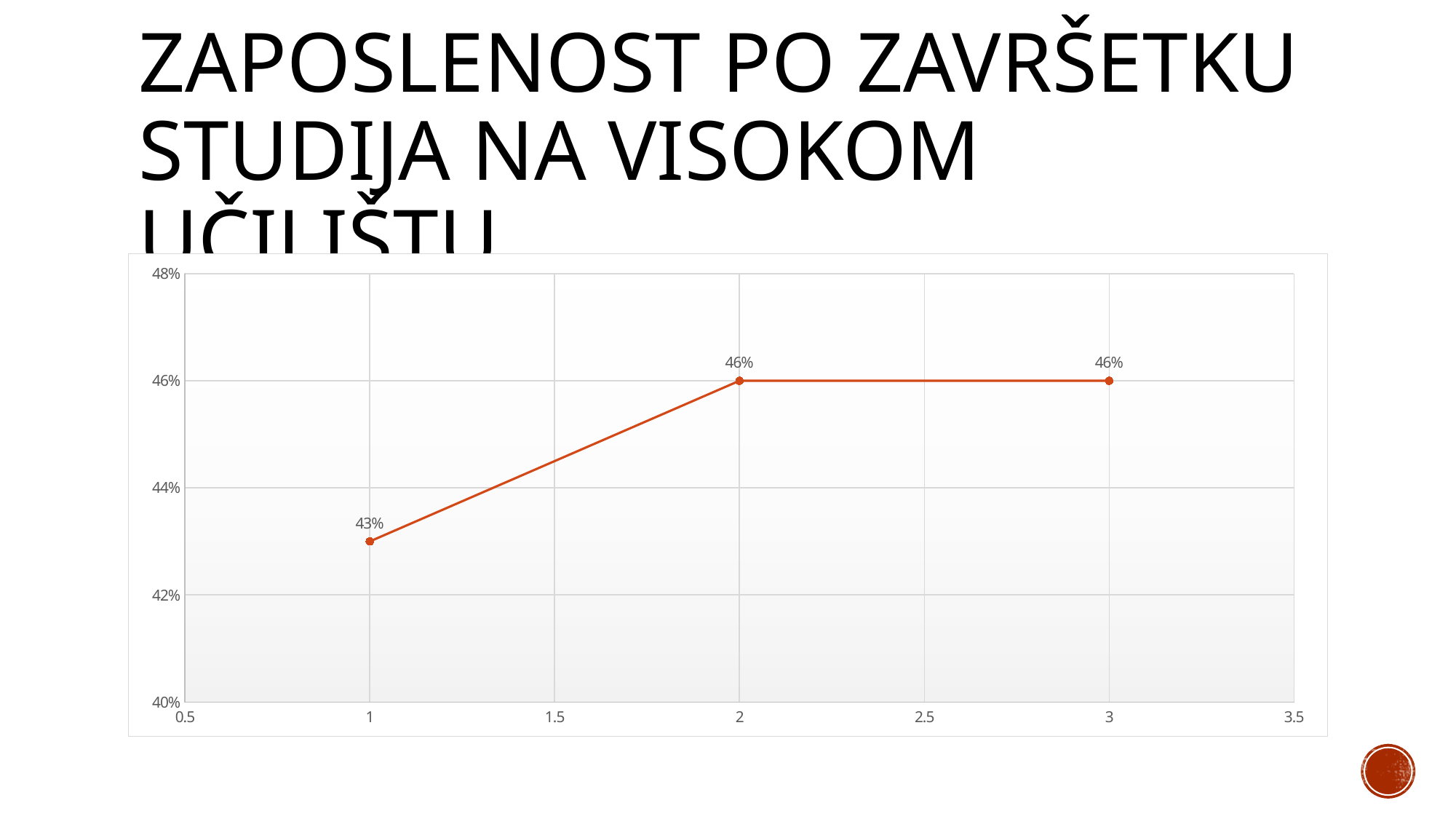
How many data points are plotted on the chart? 3 Which is larger, the value at x = 1 or the value at x = 3? x = 3 Is the value at x = 1 greater or less than 44%? less At which x value is the plotted value lowest? 1 What is the value plotted at x = 3? 46% What is the value plotted at x = 2? 46% What kind of chart is shown on the slide? line chart What is the highest value shown on the vertical axis? 48% What is the value plotted at x = 1? 43% Do the plotted values rise or fall from x = 1 to x = 2? rise Is the value at x = 3 greater or less than 44%? greater What is the difference between the value at x = 2 and the value at x = 1? 3%